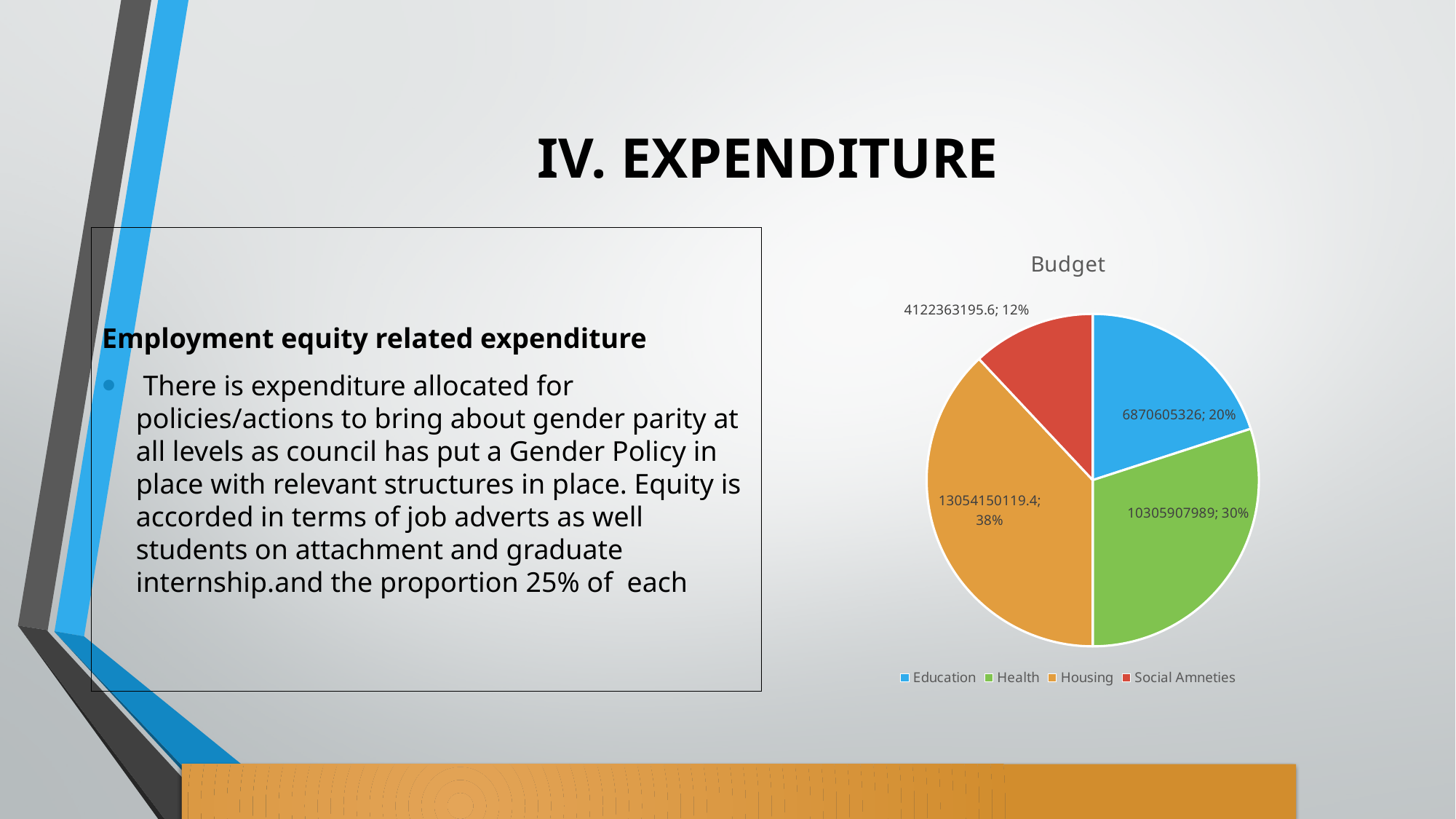
What kind of chart is shown on the slide? Pie chart Which is larger in the Budget pie chart, Education or Health? Health Which category has the largest slice in the Budget pie chart? Housing Which category has the smallest slice in the Budget pie chart? Social Amneties What value is shown for Housing in the Budget pie chart? 13054150119.4 What is the title of the chart? Budget What percentage share of the Budget pie chart does Housing have? 38% How many slices does the Budget pie chart have? 4 What colour is the Housing slice in the Budget pie chart? Orange What value is shown for Education in the Budget pie chart? 6870605326 What value is shown for Social Amneties in the Budget pie chart? 4122363195.6 What percentage share of the Budget pie chart does Health have? 30%